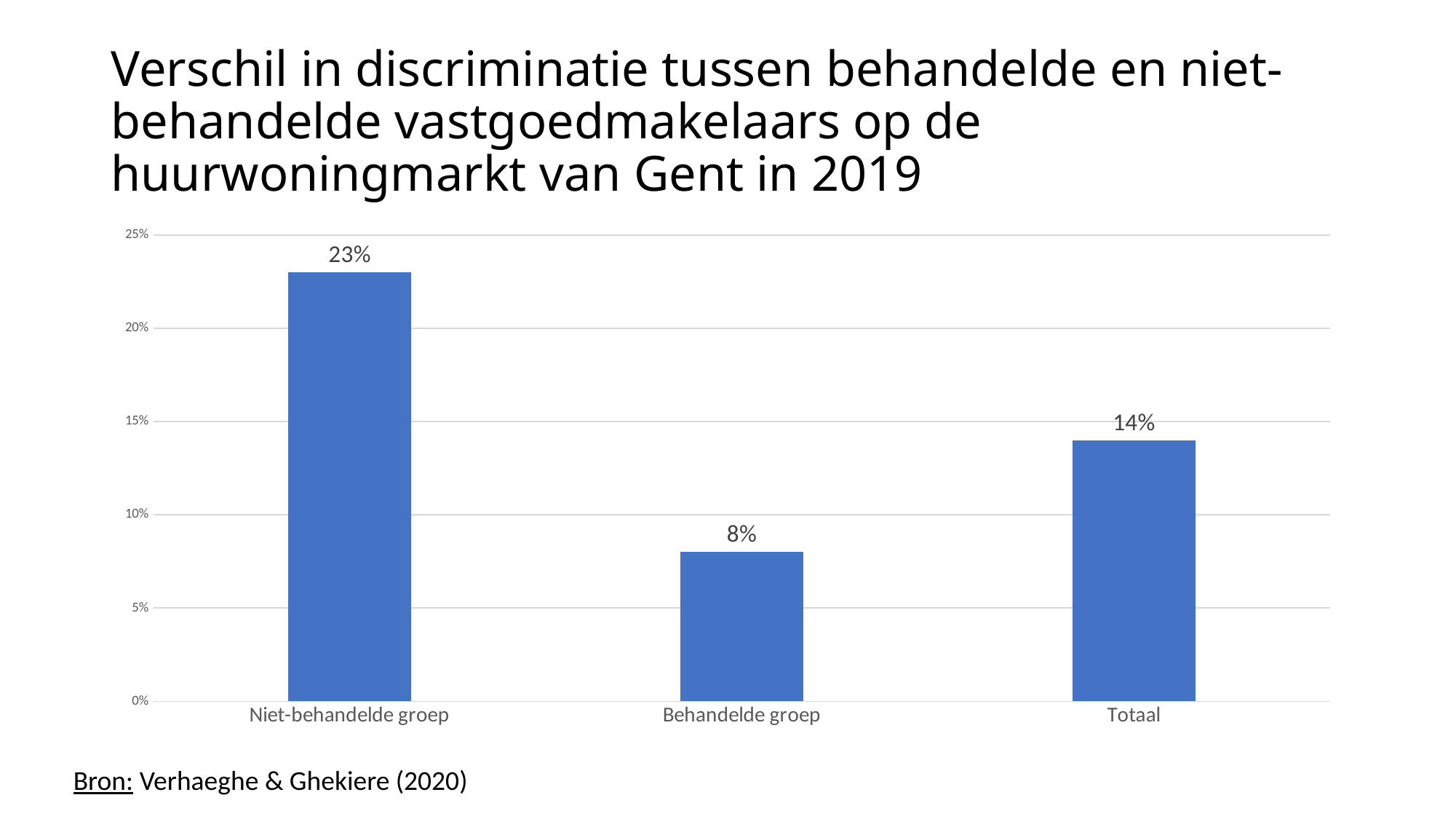
What is the difference between the values for Niet-behandelde groep and Behandelde groep? 15% Which is larger, the value for Totaal or the value for Behandelde groep? Totaal Which category has the highest value? Niet-behandelde groep What kind of chart is shown on the slide? bar chart Which category has the lowest value? Behandelde groep What is the value for Niet-behandelde groep? 23% What is the value for Totaal? 14% How many categories are shown on the x axis? 3 What source is cited below the chart? Verhaeghe & Ghekiere (2020) What is the difference between the values for Totaal and Behandelde groep? 6% What is the value for Behandelde groep? 8% Is the value for Niet-behandelde groep greater or less than 20%? greater